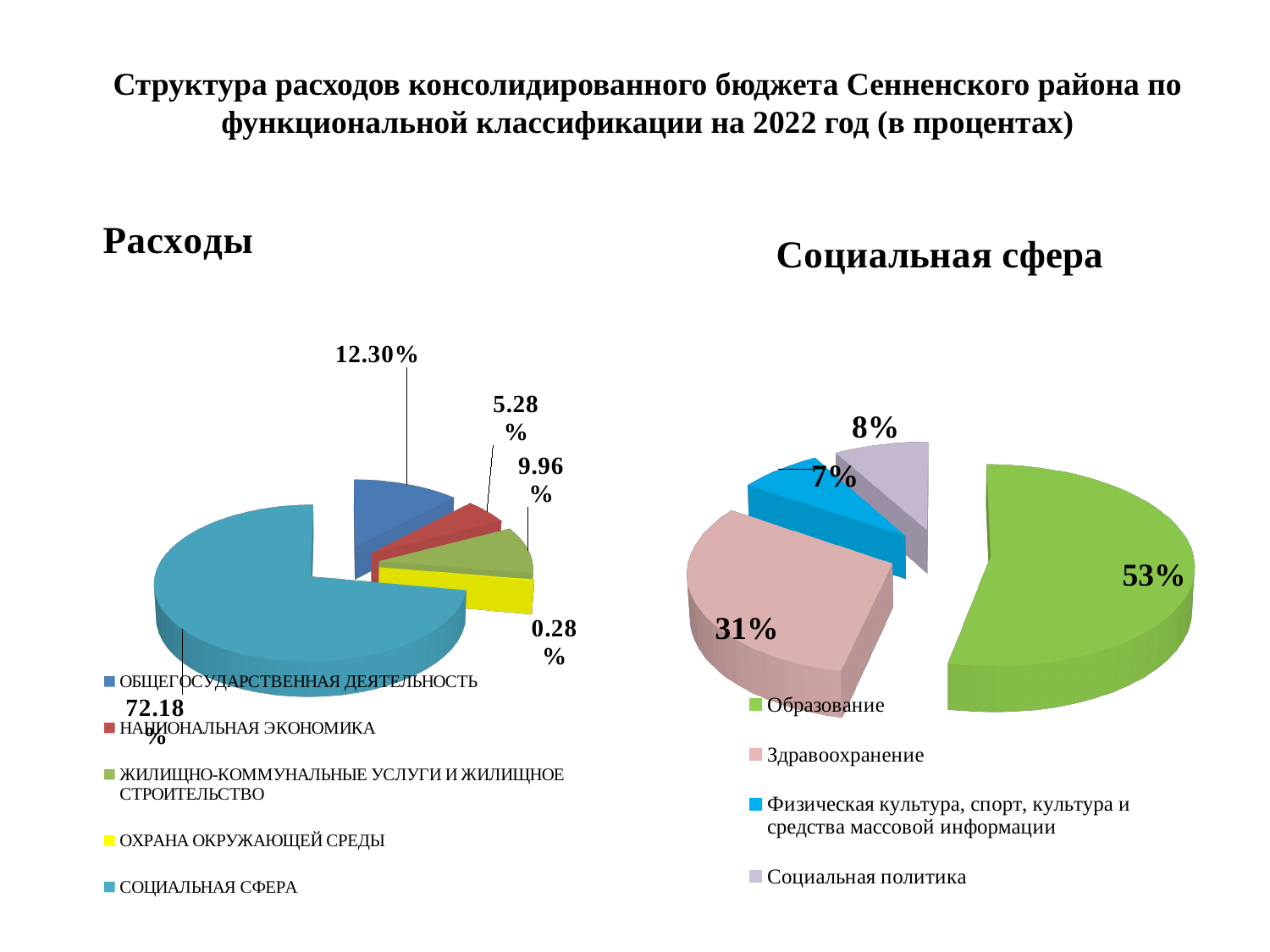
In the 'Расходы' chart, what is the difference between ОБЩЕГОСУДАРСТВЕННАЯ ДЕЯТЕЛЬНОСТЬ and НАЦИОНАЛЬНАЯ ЭКОНОМИКА? 7.02% In the 'Социальная сфера' chart, which category has the largest share? Образование How many categories does the 'Расходы' chart show? 5 In the 'Расходы' chart, which is larger: НАЦИОНАЛЬНАЯ ЭКОНОМИКА or ЖИЛИЩНО-КОММУНАЛЬНЫЕ УСЛУГИ И ЖИЛИЩНОЕ СТРОИТЕЛЬСТВО? ЖИЛИЩНО-КОММУНАЛЬНЫЕ УСЛУГИ И ЖИЛИЩНОЕ СТРОИТЕЛЬСТВО In the 'Расходы' chart, what share is shown for СОЦИАЛЬНАЯ СФЕРА? 72.18% In the 'Социальная сфера' chart, what is the difference between Образование and Здравоохранение? 22% In the 'Расходы' chart, which category has the smallest share? ОХРАНА ОКРУЖАЮЩЕЙ СРЕДЫ In the 'Расходы' chart, what share is shown for ОХРАНА ОКРУЖАЮЩЕЙ СРЕДЫ? 0.28% In the 'Социальная сфера' chart, what share is shown for Здравоохранение? 31% What type of chart is the 'Социальная сфера' chart? Pie chart In the 'Социальная сфера' chart, what share is shown for Социальная политика? 8% In the 'Расходы' chart, what share is shown for ОБЩЕГОСУДАРСТВЕННАЯ ДЕЯТЕЛЬНОСТЬ? 12.30%